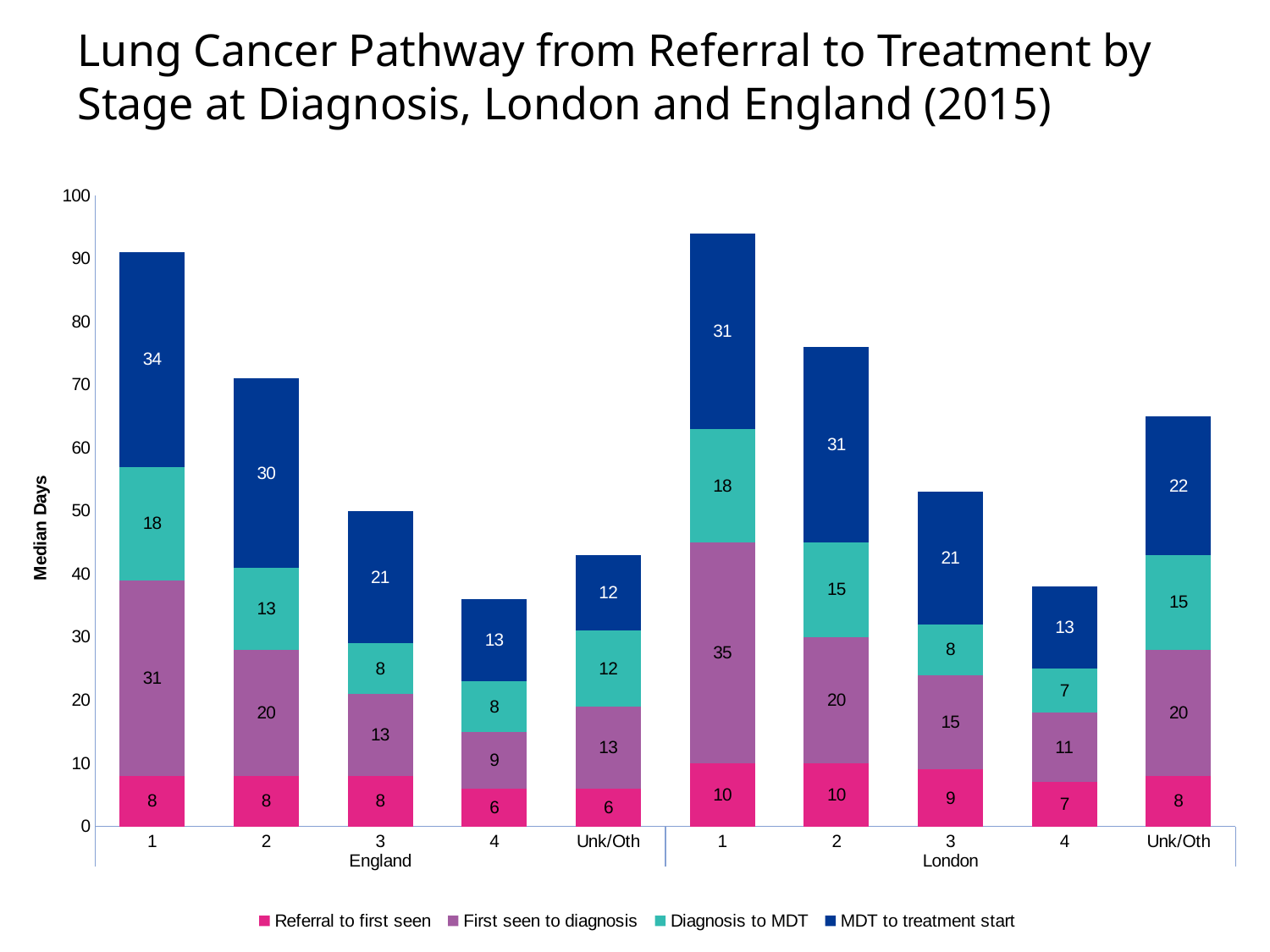
Which stage has the tallest stacked bar in the London group? 1 What is the median number of days from MDT to treatment start for stage 1 in England? 34 Which is larger: the first seen to diagnosis value for Unk/Oth in England or for Unk/Oth in London? London How many series does the legend list? 4 What is the total median days for the stage 4 bar in England? 36 What is the median number of days from referral to first seen for stage 4 in England? 6 What is the median number of days from first seen to diagnosis for stage 1 in London? 35 What is the difference in MDT to treatment start days between stage 2 in England and stage 2 in London? 1 Which stage has the shortest stacked bar in the England group? 4 What type of chart is shown on the slide? Stacked bar chart What is the median number of days from diagnosis to MDT for Unk/Oth in London? 15 What is the total median days for the stage 1 bar in London? 94